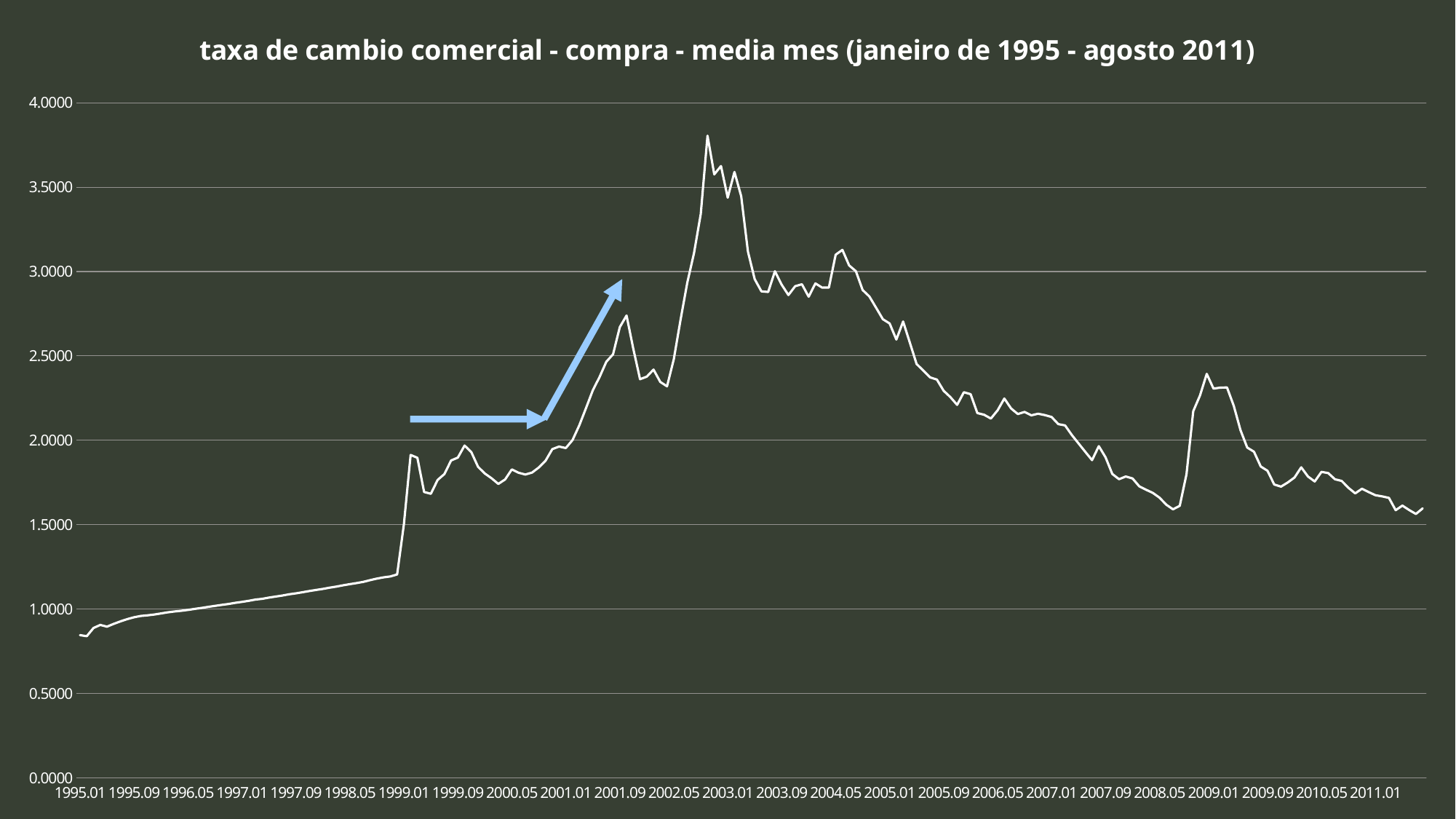
Does the line rise or fall between 1995.01 and 1998.05? rise What is the title of the chart? taxa de cambio comercial - compra - media mes (janeiro de 1995 - agosto 2011) Is the highest value on the line greater or less than 3.5000? greater Which is larger, the value at 2003.01 or the value at 2009.01? 2003.01 Which is larger, the value at 1995.01 or the value at 2011.01? 2011.01 Is the value at 2011.01 greater or less than 2.0000? less Is the value at 2009.01 greater or less than 2.0000? greater Does the line rise or fall between 2003.01 and 2007.09? fall What kind of chart is shown on the slide? line chart